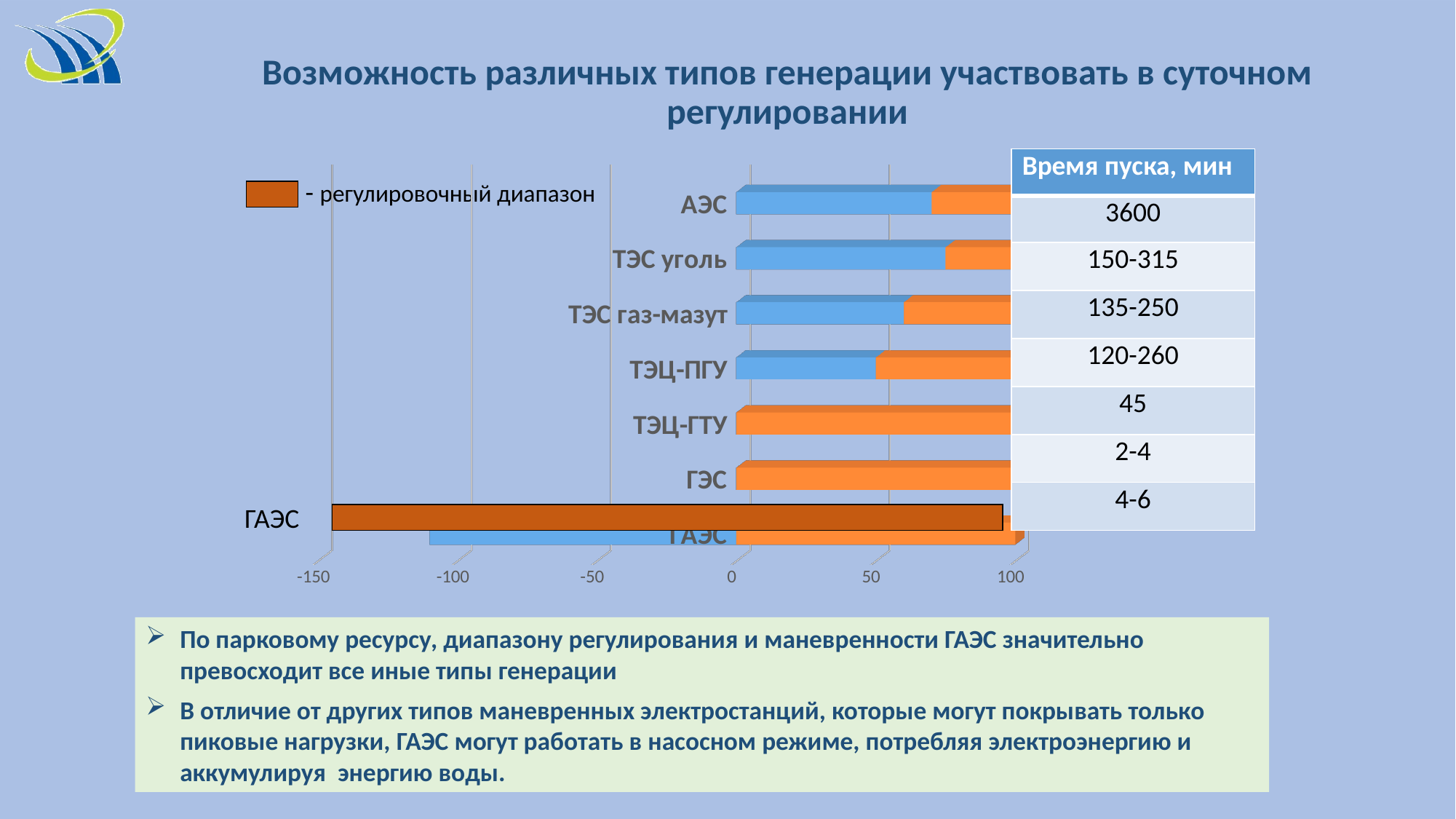
Is the end of the blue bar for АЭС greater or less than 50? greater Which category is the only one whose bar extends into negative values on the x axis? ГАЭС What is the highest value shown on the x axis? 100 Is the end of the blue bar for ТЭС газ-мазут greater or less than 50? greater Which category is listed at the bottom of the chart? ГАЭС What is the lowest value shown on the x axis? -150 Which category is listed at the top of the chart? АЭС What kind of chart is shown on the slide? bar chart Is the end of the blue bar for ТЭС уголь greater or less than 50? greater How many generation types (categories) are plotted on the chart? 7 Which of the two blue bars is longer: АЭС or ТЭЦ-ПГУ? АЭС